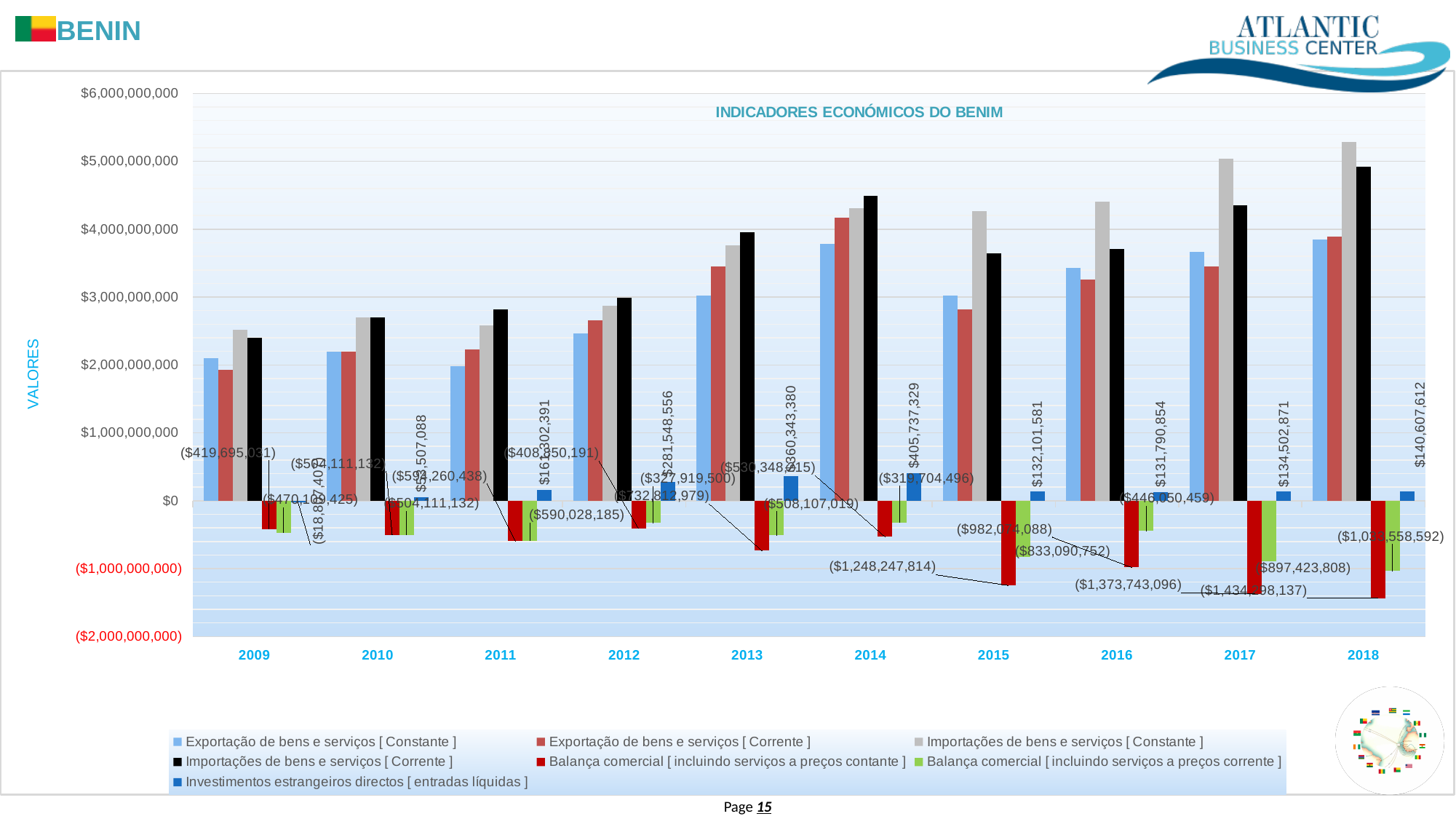
In 2015, which is larger: Exportação de bens e serviços [Constante] or Exportação de bens e serviços [Corrente]? Exportação de bens e serviços [Constante] What is the value of Investimentos estrangeiros directos [entradas líquidas] in 2014? $405,737,329 Does Importações de bens e serviços [Constante] generally rise or fall from 2009 to 2018? rise What is the title of the chart? INDICADORES ECONÓMICOS DO BENIM How many years are shown on the x axis? 10 Is the value of Exportação de bens e serviços [Corrente] in 2014 greater or less than $4,000,000,000? greater Is the value of Importações de bens e serviços [Constante] in 2018 greater or less than $5,000,000,000? greater What kind of chart is shown on the slide? bar chart How many series does the legend list? 7 In which year is Investimentos estrangeiros directos [entradas líquidas] highest? 2014 What is the value of Investimentos estrangeiros directos [entradas líquidas] in 2018? $140,607,612 What is the difference between Investimentos estrangeiros directos [entradas líquidas] in 2018 and in 2017? $6,104,741